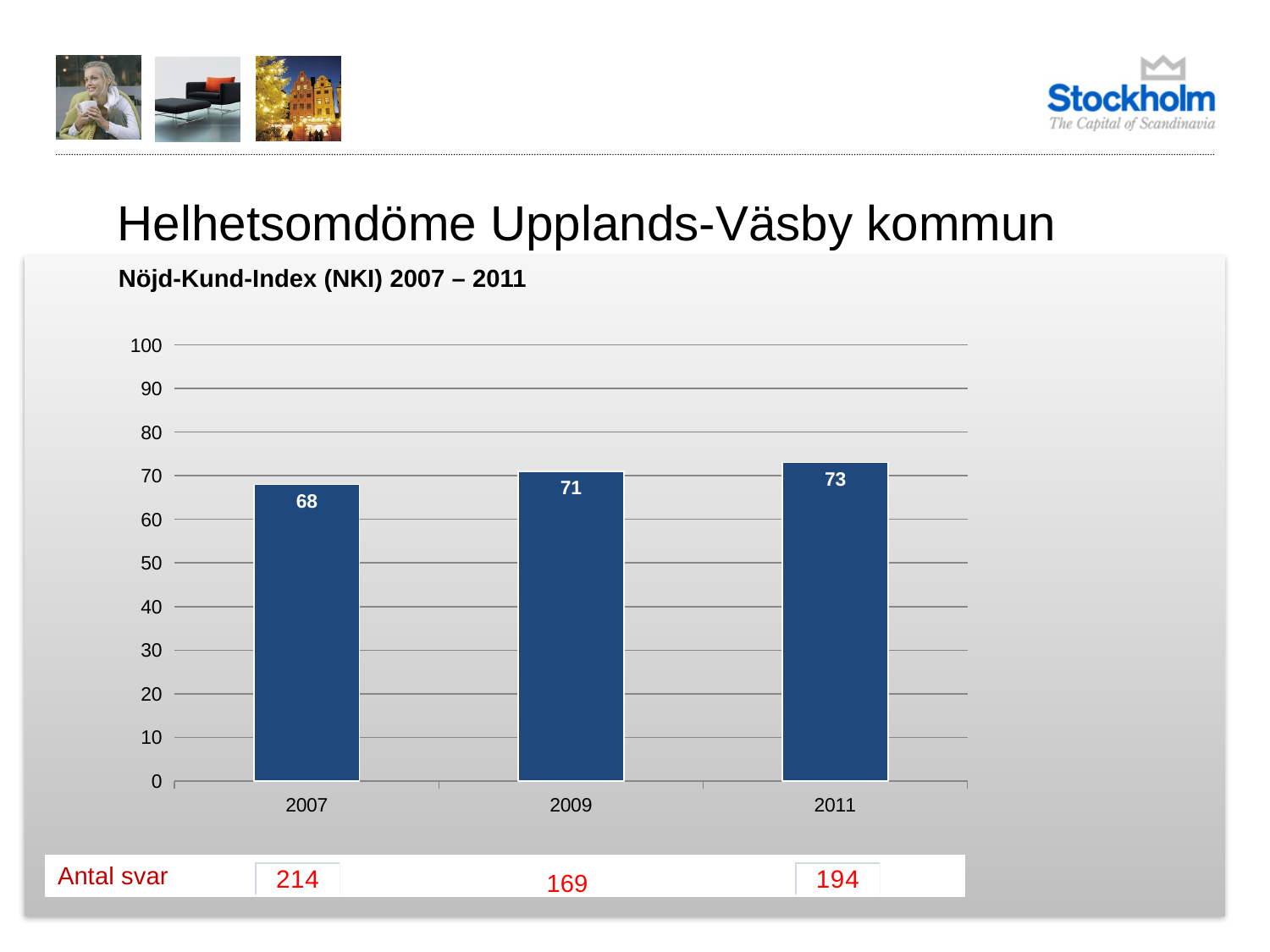
What is the difference between the NKI values for 2009 and 2007? 3 What is the NKI value for 2009? 71 Which year has the lowest NKI value? 2007 Is the NKI value for 2011 greater or less than 70? greater What is the difference between the NKI values for 2011 and 2007? 5 How many years are shown in the chart? 3 What is the NKI value for 2011? 73 Do the NKI values rise or fall from 2007 to 2011? rise What is the NKI value for 2007? 68 Which year has the highest NKI value? 2011 Which is larger, the NKI value for 2009 or for 2011? 2011 What kind of chart is shown on the slide? bar chart